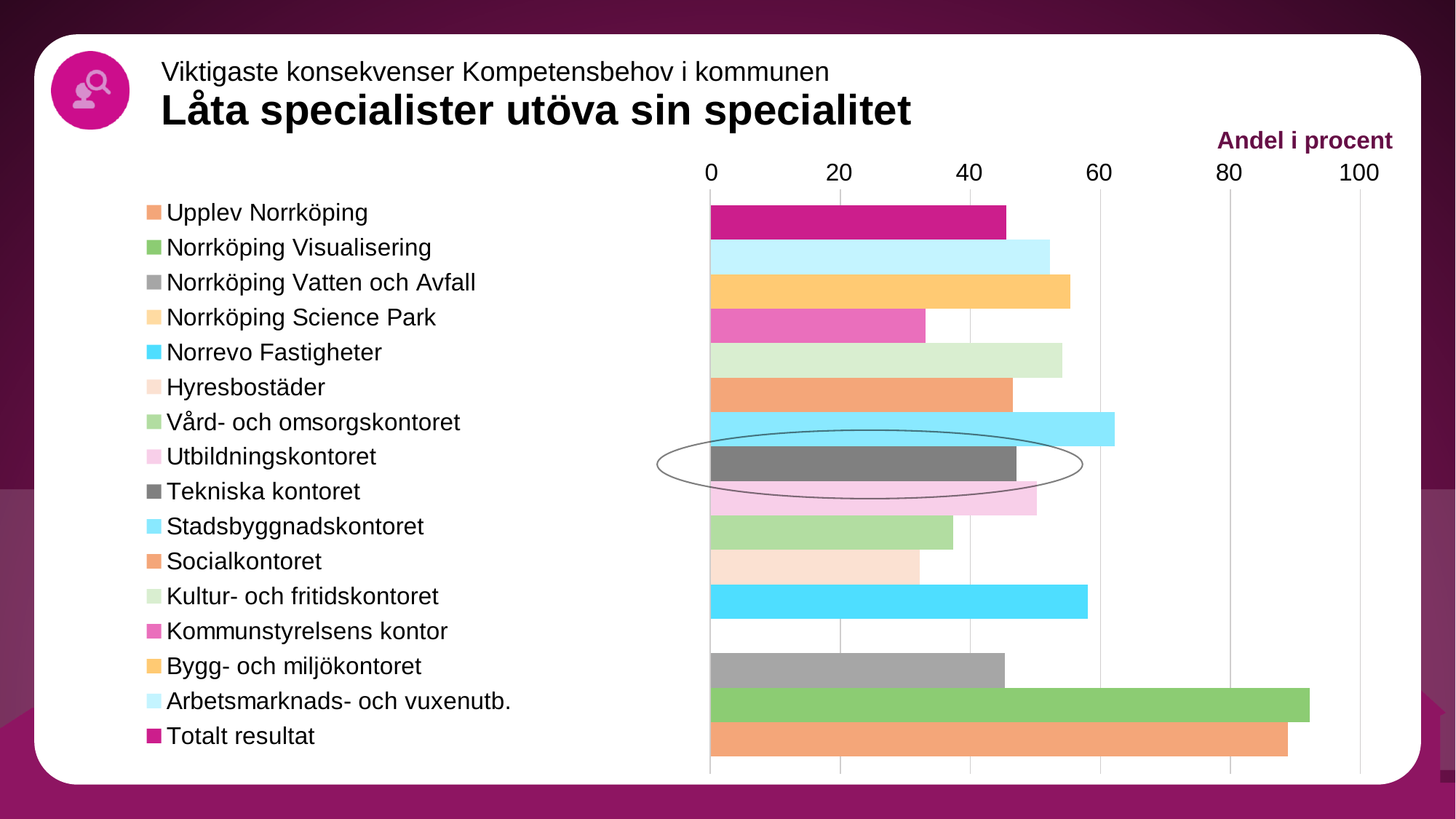
Which is larger, the value for Stadsbyggnadskontoret or the value for Hyresbostäder? Stadsbyggnadskontoret Is the value for Stadsbyggnadskontoret greater or less than 40? greater Which legend entry's bar is circled on the chart? Tekniska kontoret Is the value for Kommunstyrelsens kontor greater or less than 40? less Is the value for Hyresbostäder greater or less than 40? less Which legend entry has the longest bar in the chart? Norrköping Visualisering Which is larger, the value for Norrevo Fastigheter or the value for Kommunstyrelsens kontor? Norrevo Fastigheter What kind of chart is shown on the slide? bar chart How many entries does the chart legend list? 16 What is the axis title shown above the chart's horizontal axis? Andel i procent